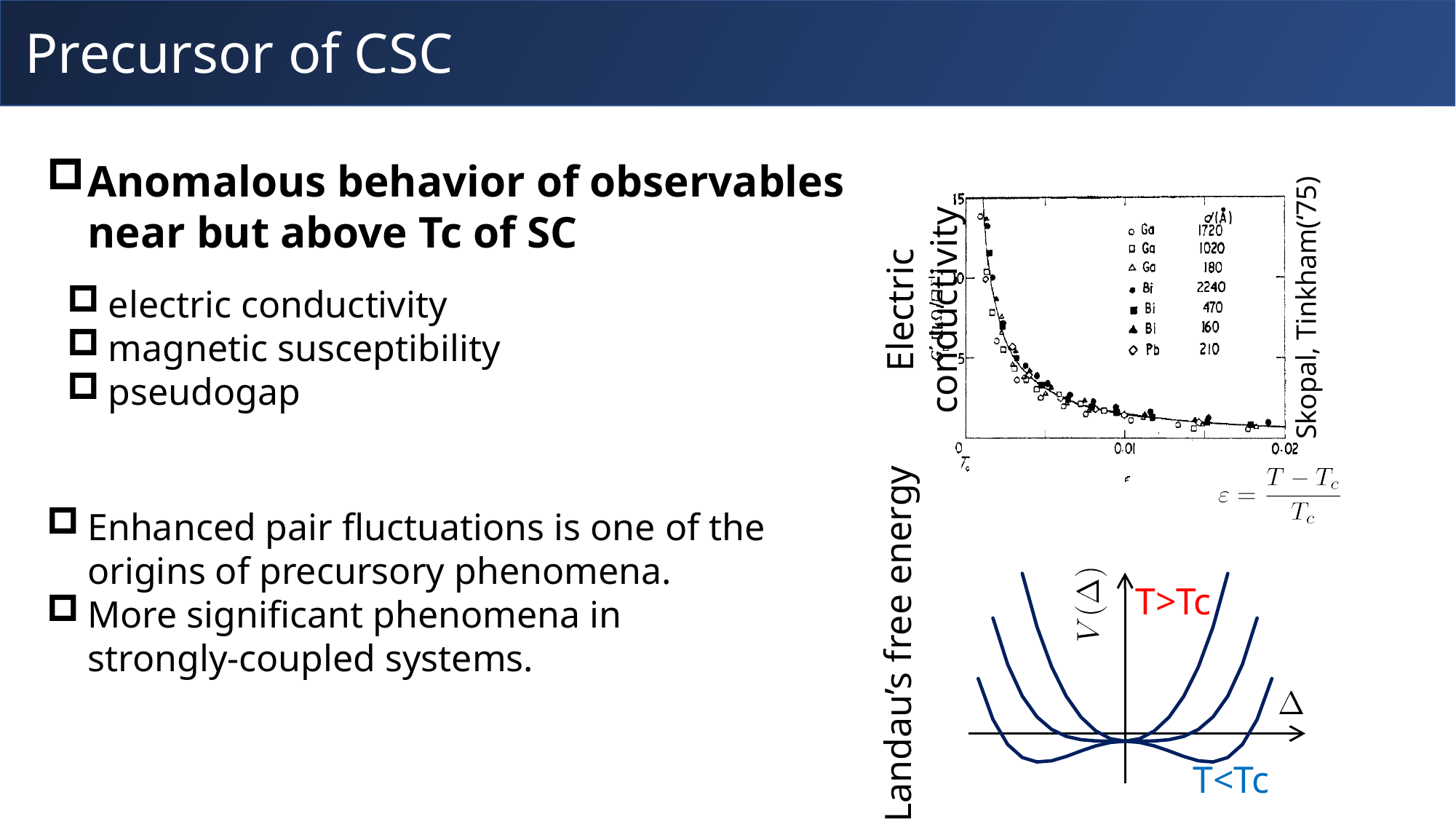
In the top-right chart (electric conductivity), which legend entry has the smallest d(Å) value? Bi 160 In the top-right chart (electric conductivity), what d(Å) value is listed for Pb in the legend? 210 In the top-right chart (electric conductivity), which is larger, the d(Å) value for Bi 470 or for Pb 210? Bi 470 In the top-right chart (electric conductivity), how many legend entries are for Ga? 3 In the top-right chart (electric conductivity), do the plotted values rise or fall as ε increases? fall In the bottom-right chart (Landau's free energy), how many curves are drawn? 3 In the bottom-right chart (Landau's free energy), which temperature label is written in red? T>Tc In the top-right chart (electric conductivity), what kind of chart is it? scatter plot In the top-right chart (electric conductivity), what is the difference between the d(Å) values of Ga 1720 and Ga 1020? 700 In the top-right chart (electric conductivity), how many entries does the legend list? 7 In the top-right chart (electric conductivity), what is the largest value shown on the x axis? 0.02 In the top-right chart (electric conductivity), which legend entry has the largest d(Å) value? Bi 2240